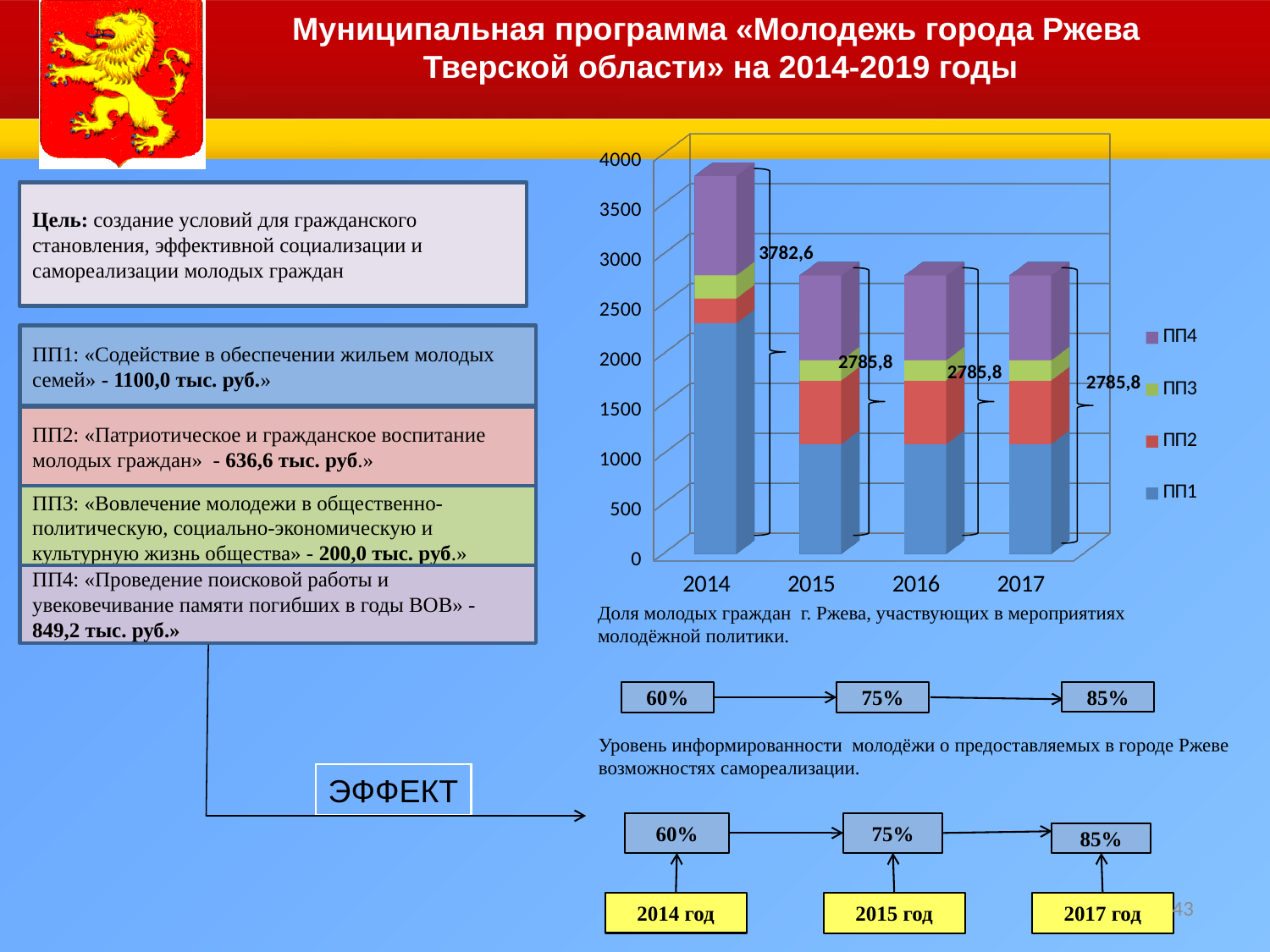
Is the total for 2014 greater or less than 3500? greater Does the total value rise or fall from 2014 to 2015? fall Which year has the highest total in the stacked bar chart? 2014 What is the difference between the total for 2014 and the total for 2015? 996,8 Which is larger, the total for 2014 or the total for 2016? 2014 What is the total value of the stacked bar for 2015? 2785,8 What kind of chart is shown on the slide? stacked bar chart How many years are shown on the x axis of the chart? 4 How many series does the chart legend list? 4 What is the total value of the stacked bar for 2017? 2785,8 What is the total value of the stacked bar for 2014? 3782,6 Is the total for 2016 greater or less than 3000? less